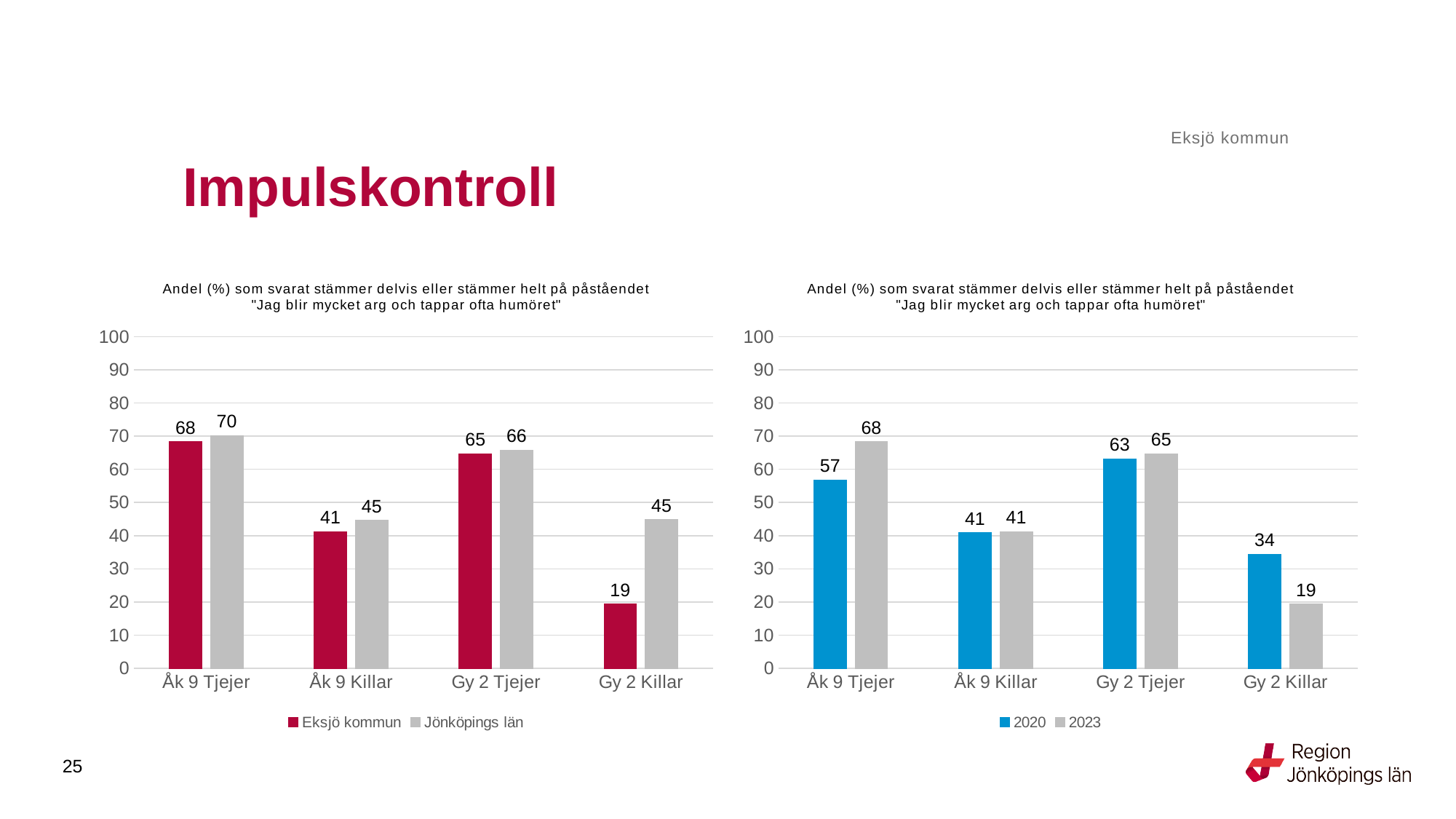
In the left chart, what is the value for Eksjö kommun for Gy 2 Killar? 19 How many categories are shown on the x axis of the left chart? 4 In the right chart, what is the value for 2020 for Åk 9 Tjejer? 57 How many series does the legend of the right chart list? 2 In the right chart, which is larger for Åk 9 Tjejer: the 2020 value or the 2023 value? 2023 In the right chart, what is the difference between the 2020 and 2023 values for Gy 2 Killar? 15 In the left chart, which category has the highest value for Eksjö kommun? Åk 9 Tjejer In the right chart, which category has the lowest value for 2023? Gy 2 Killar In the left chart, what is the value for Jönköpings län for Åk 9 Killar? 45 What type of chart is the left chart? Bar chart In the left chart, what is the difference between Jönköpings län and Eksjö kommun for Gy 2 Killar? 26 In the right chart, what is the value for 2023 for Gy 2 Killar? 19